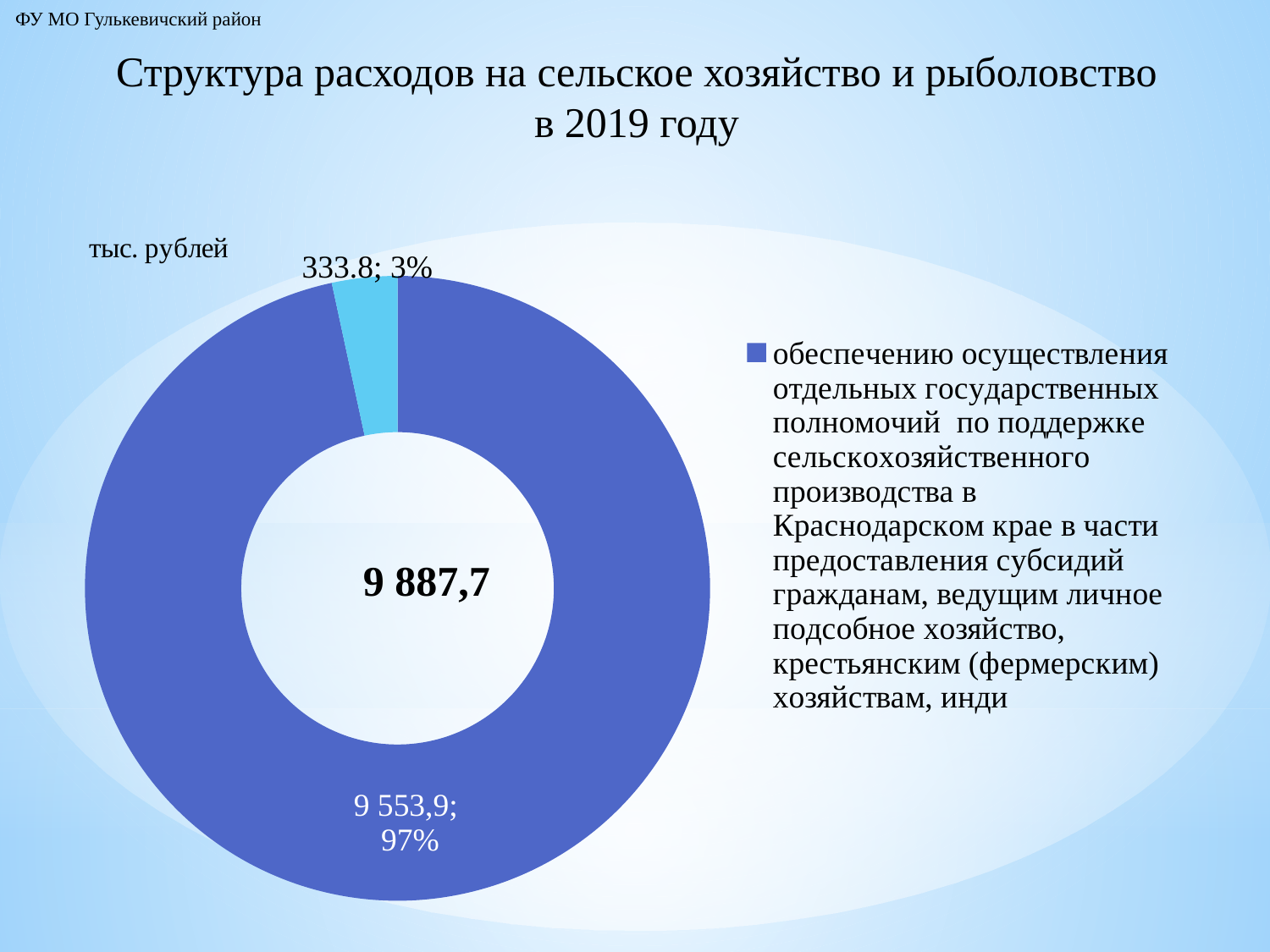
What share of the total does the largest slice represent? 97% What is the difference between the two slice values, 9 553,9 and 333.8? 9 220,1 How many slices does the doughnut chart have? 2 What total value is printed in the centre of the doughnut chart? 9 887,7 What is the value of the small light-blue slice? 333.8 What is the value of the largest slice of the doughnut chart? 9 553,9 How many entries does the legend list? 1 Which slice is larger: the dark-blue slice or the light-blue slice? the dark-blue slice (9 553,9) What is the title of the chart on the slide? Структура расходов на сельское хозяйство и рыболовство в 2019 году What kind of chart is shown on the slide? doughnut (pie) chart What share of the total does the small light-blue slice represent? 3% In what units are the values on the chart given? тыс. рублей